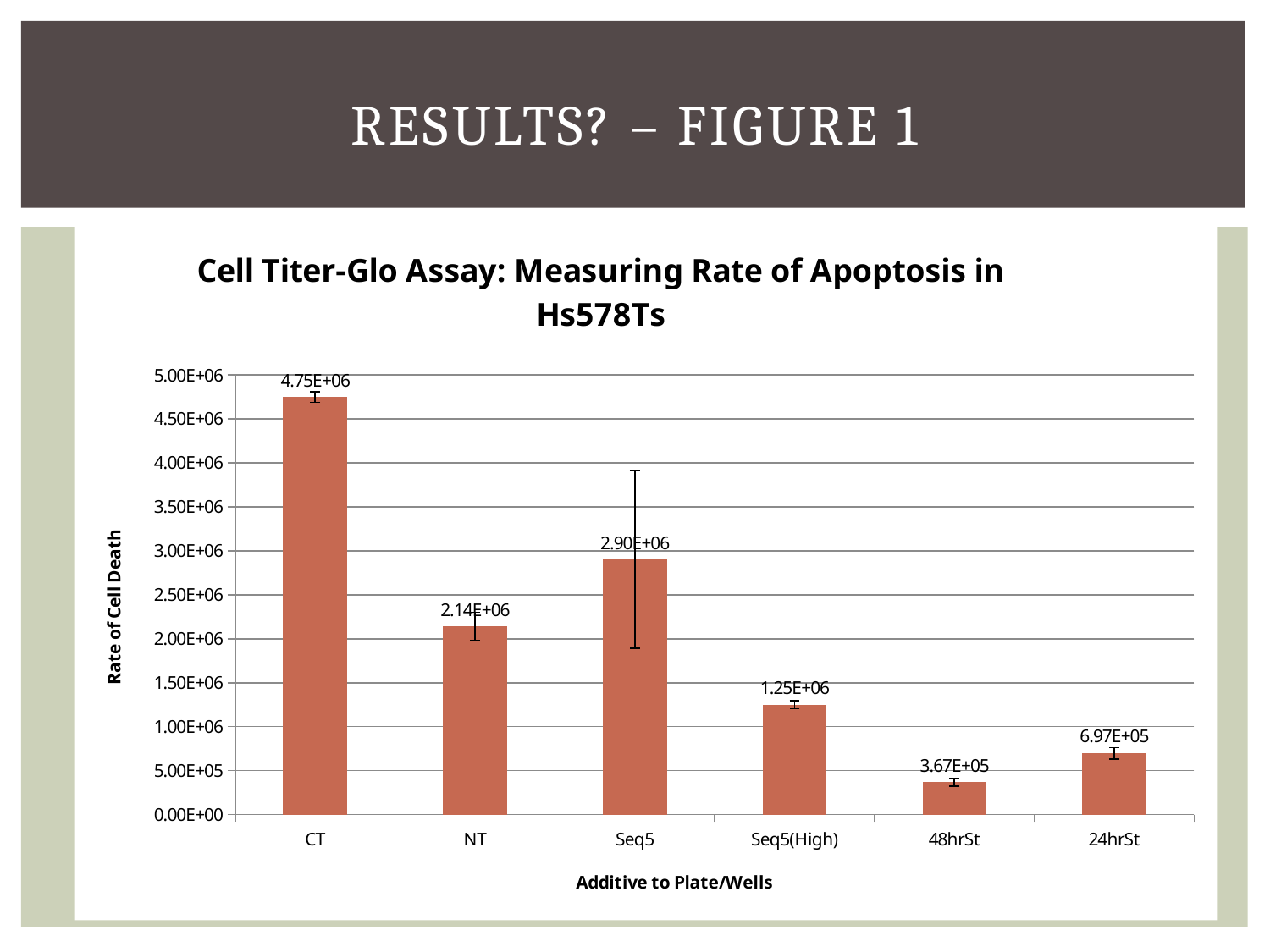
Is the value for Seq5 greater or less than 2.50E+06? greater What kind of chart is shown? Bar chart How many additives are shown on the x axis? 6 Which has a larger value, NT or Seq5? Seq5 Which additive has the highest rate of cell death? CT What is the label of the x axis? Additive to Plate/Wells What is the value for CT? 4.75E+06 Is the value for NT greater or less than 2.50E+06? less What is the label of the y axis? Rate of Cell Death What is the value for Seq5(High)? 1.25E+06 Which additive has the lowest rate of cell death? 48hrSt What is the value for 24hrSt? 6.97E+05